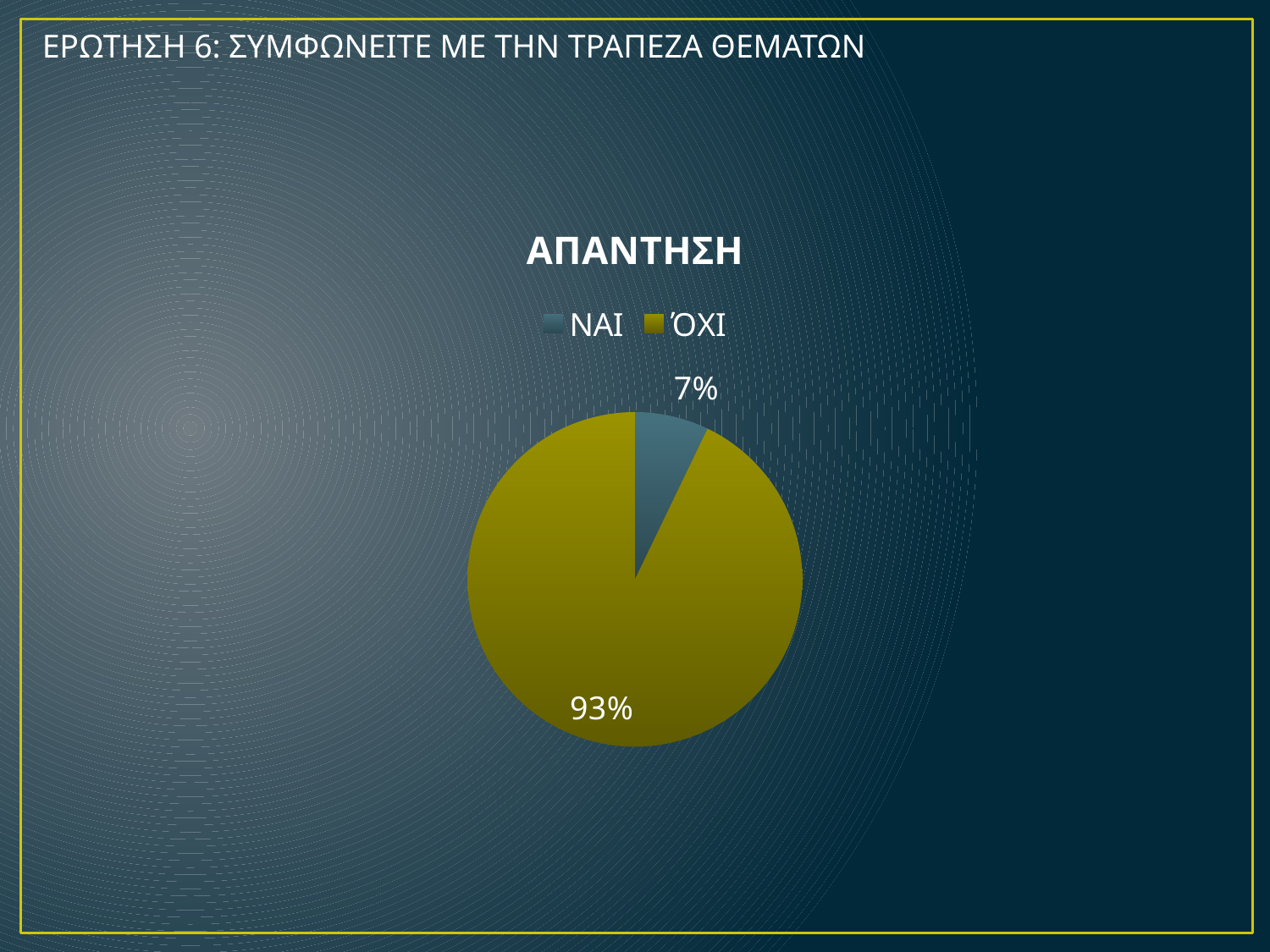
Which category has the largest share of the pie chart? ΌΧΙ Which slice is larger, ΝΑΙ or ΌΧΙ? ΌΧΙ Which category has the smallest share of the pie chart? ΝΑΙ What is the title of the chart? ΑΠΑΝΤΗΣΗ How many slices does the pie chart have? 2 What type of chart is shown on the slide? Pie chart What colour is the ΌΧΙ slice in the pie chart? Olive/yellow-green How many entries does the chart legend list? 2 What percentage of the pie chart is labelled ΌΧΙ? 93% What share of the pie does the ΌΧΙ slice represent? 93% What is the difference in percentage points between the ΌΧΙ and ΝΑΙ slices? 86 What percentage of the pie chart is labelled ΝΑΙ? 7%